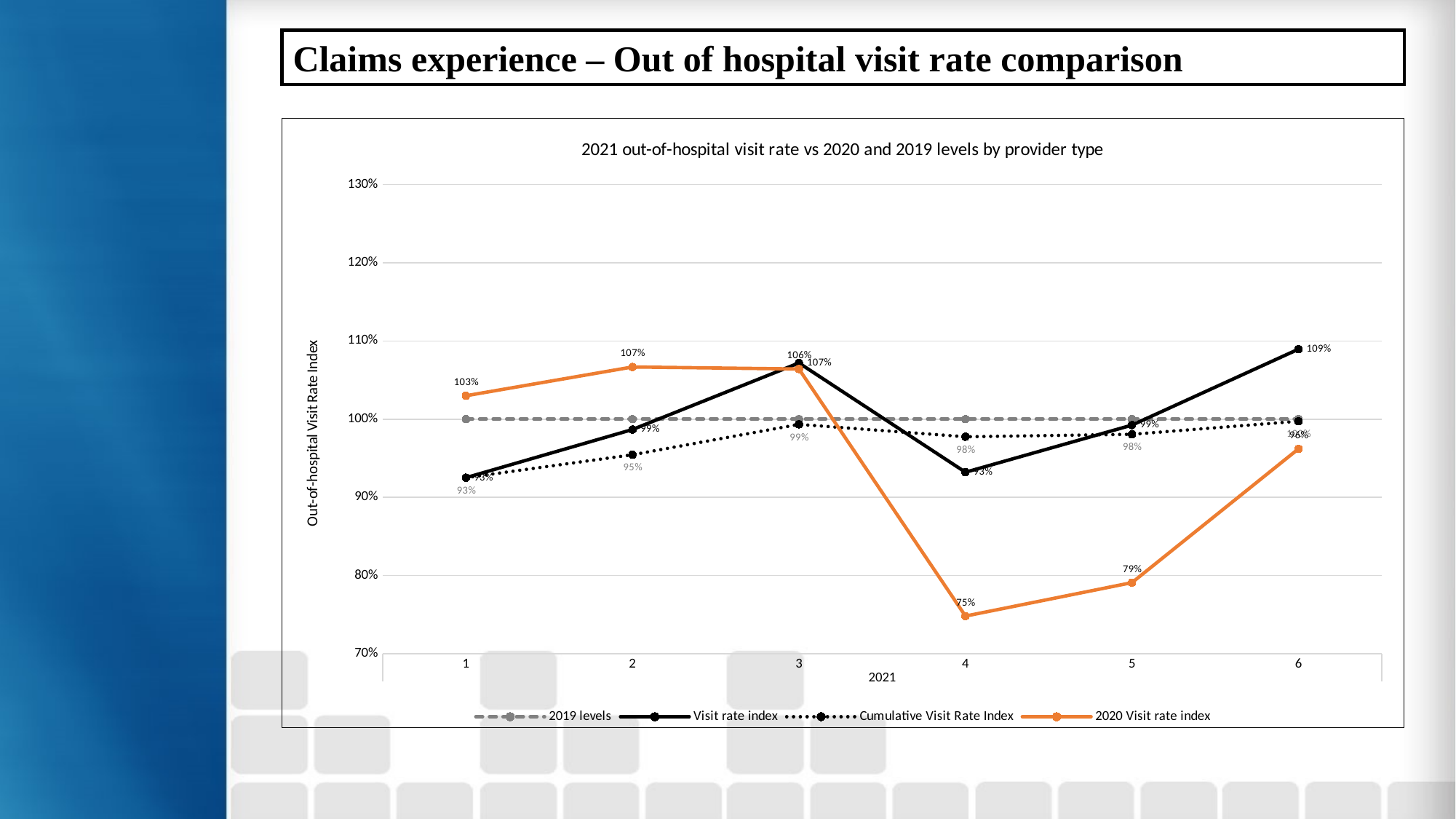
What is the value of the Visit rate index at point 6? 109% What kind of chart is shown on the slide? Line chart How many series does the legend list? 4 At which point is the Visit rate index highest? 6 How many points are plotted along the x axis for each series? 6 What is the value of the Cumulative Visit Rate Index at point 2? 95% Does the 2020 Visit rate index rise or fall from point 4 to point 6? Rises At point 4, which is larger: the Visit rate index or the 2020 Visit rate index? Visit rate index What is the difference between the 2020 Visit rate index at point 5 and at point 4? 4 percentage points At which point is the 2020 Visit rate index lowest? 4 What is the value of the 2020 Visit rate index at point 4? 75% Is the value of the Visit rate index at point 3 greater or less than 100%? greater